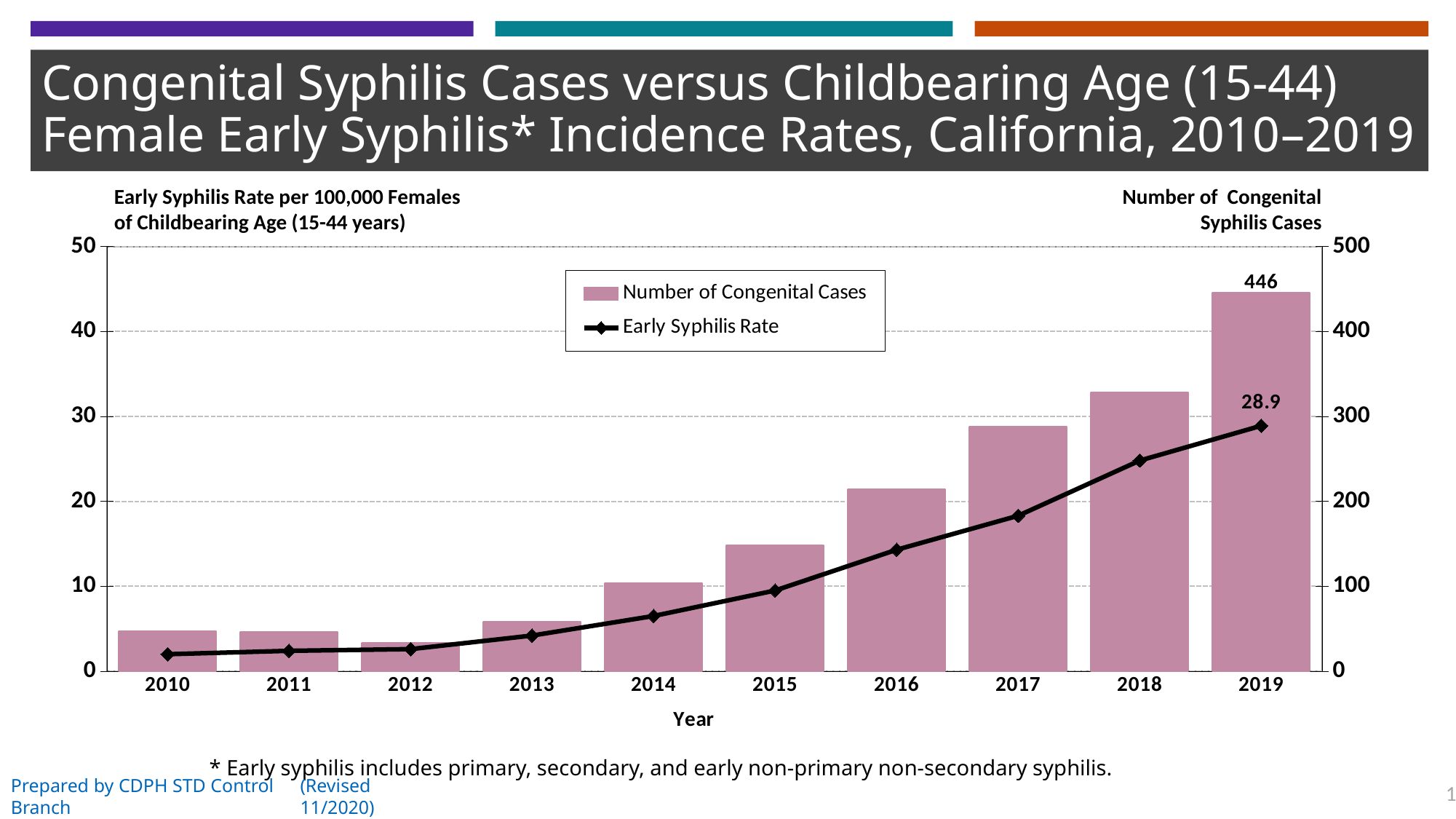
What is the early syphilis rate in 2019? 28.9 Which year has the highest number of congenital cases? 2019 How many series does the legend list? 2 Which year has the lowest early syphilis rate? 2010 Which year has more congenital cases, 2015 or 2017? 2017 Is the number of congenital cases in 2018 greater or less than 300? greater Is the early syphilis rate in 2017 greater or less than 20? less What kind of chart is used for the Number of Congenital Cases series? bar chart Is the number of congenital cases in 2016 greater or less than 200? greater What is the number of congenital syphilis cases in 2019? 446 Does the early syphilis rate rise or fall from 2010 to 2019? rise How many years are shown on the x axis? 10